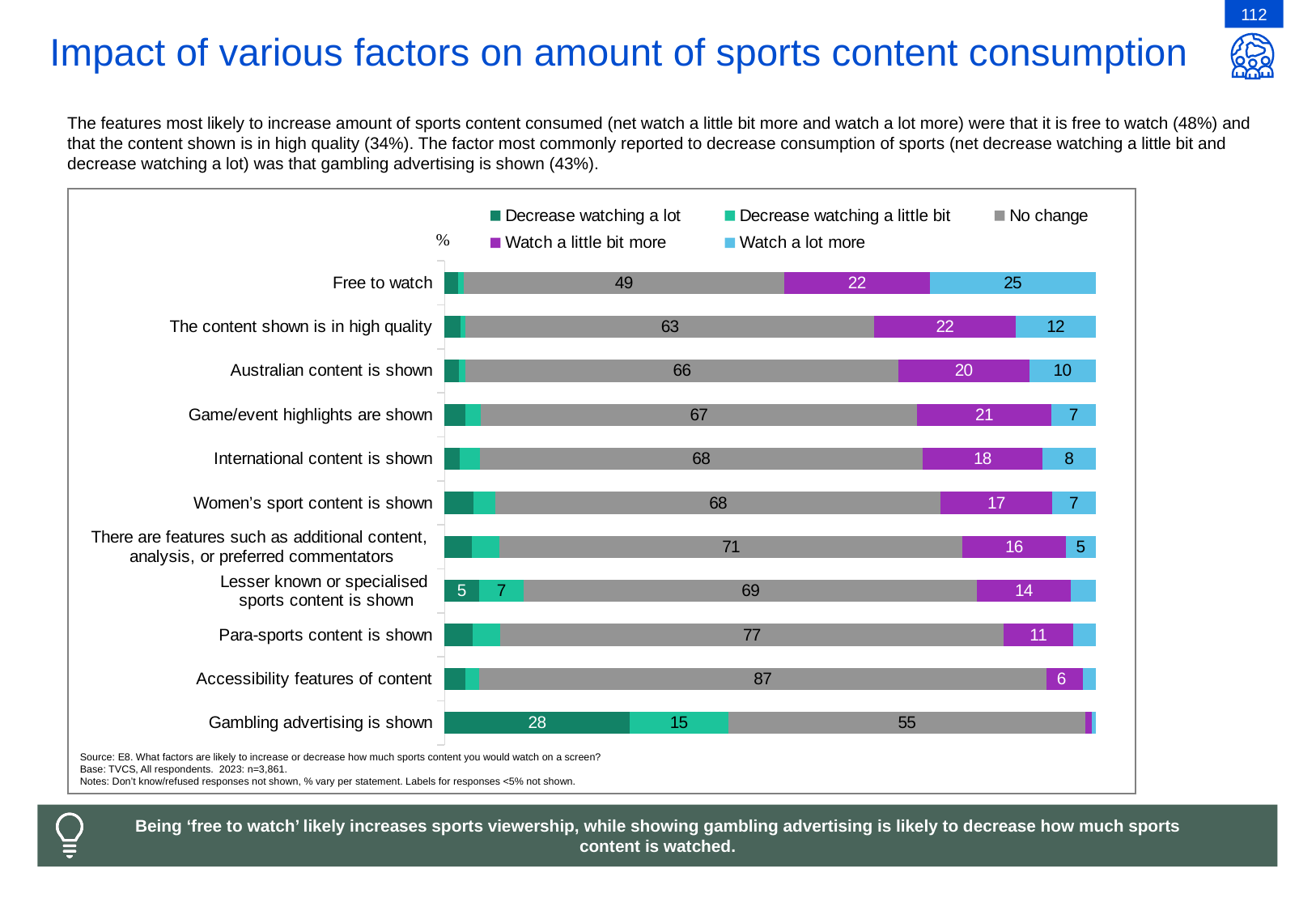
How many series does the legend list? 5 How many categories (factors) are shown in the chart? 11 Which is larger: the 'No change' value for 'Accessibility features of content' or for 'Gambling advertising is shown'? Accessibility features of content What is the 'No change' value for 'Free to watch'? 49 Which category has the highest 'No change' value? Accessibility features of content What is the 'Decrease watching a lot' value for 'Gambling advertising is shown'? 28 What kind of chart is shown on the slide? Stacked bar chart What is the 'Watch a little bit more' value for 'Para-sports content is shown'? 11 Which category has the highest 'Watch a lot more' value? Free to watch Which category has the lowest 'No change' value? Free to watch What is the 'Watch a lot more' value for 'The content shown is in high quality'? 12 What is the difference between the 'Watch a lot more' values for 'Free to watch' and 'The content shown is in high quality'? 13